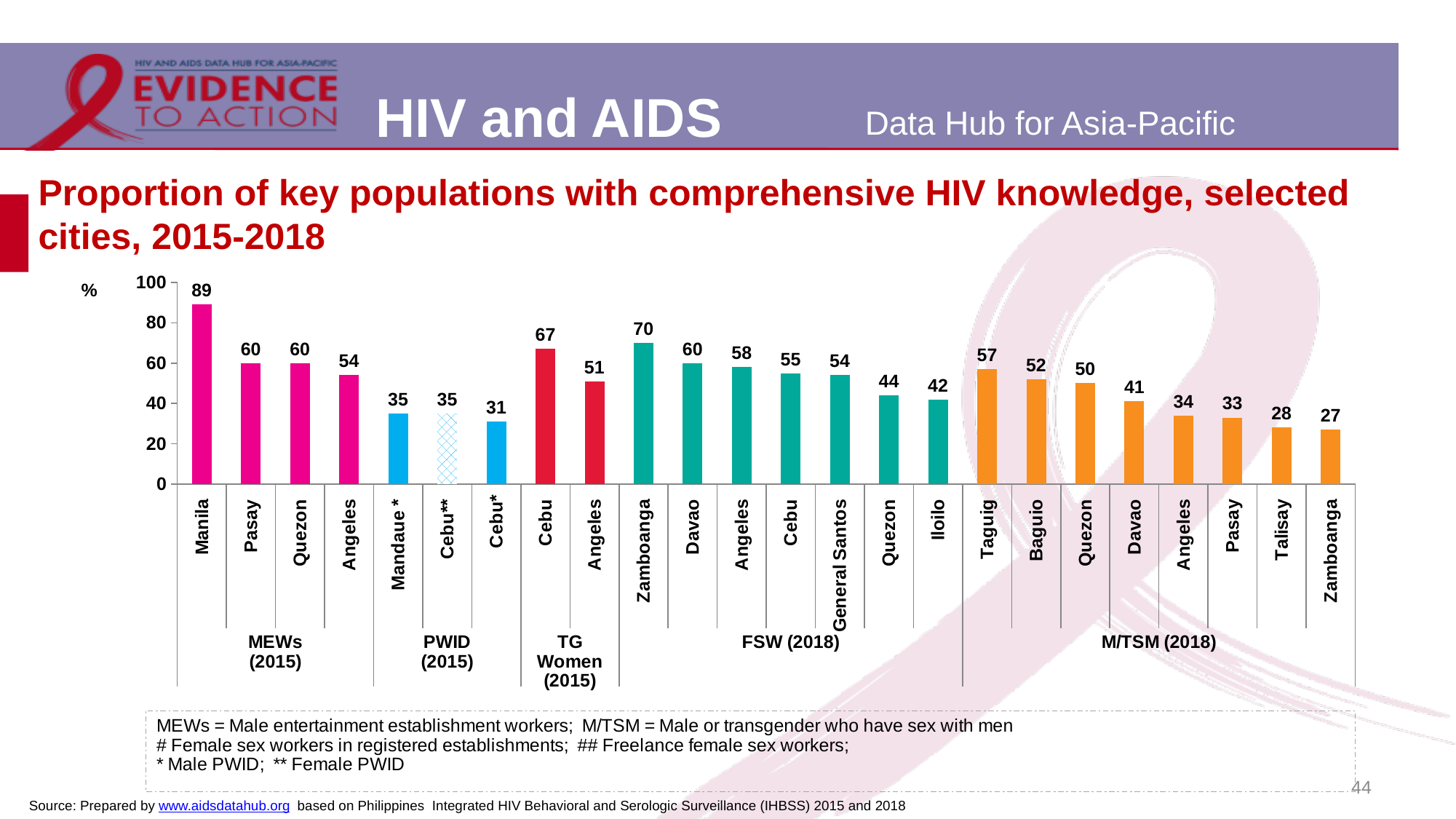
Which is larger: Davao in the FSW (2018) group or Davao in the M/TSM (2018) group? Davao in the FSW (2018) group Which city has the lowest value in the M/TSM (2018) group? Zamboanga Which city has the highest value across the whole chart? Manila Is the value for Cebu* in the PWID (2015) group greater or less than 40? less What is the value for Zamboanga in the FSW (2018) group? 70 How many cities are shown in the FSW (2018) group? 7 What is the difference between Cebu and Angeles in the TG Women (2015) group? 16 What is the value for Manila in the MEWs (2015) group? 89 How many bars are plotted in total on the chart? 24 What kind of chart is shown on the slide? Bar chart What is the value for Taguig in the M/TSM (2018) group? 57 Do the values rise or fall from Taguig to Zamboanga within the M/TSM (2018) group? Fall